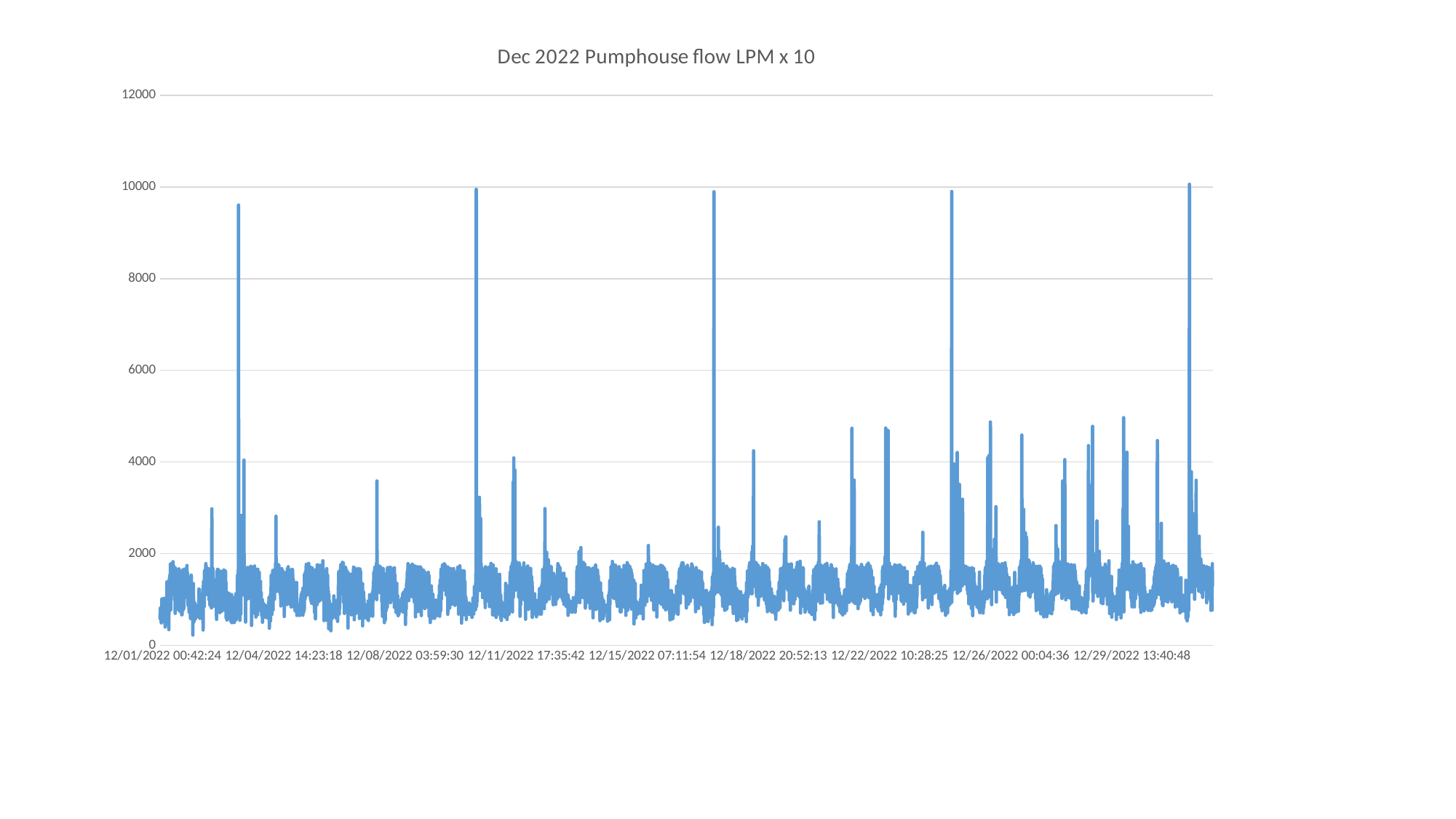
What is the highest value shown on the vertical axis? 12000 What is the first date label on the horizontal axis? 12/01/2022 00:42:24 Is the highest peak in the chart greater or less than 8000? greater How many date labels are shown along the horizontal axis? 9 What kind of chart is shown on the slide? line chart How many spikes in the chart rise above 8000? 5 Is the typical baseline flow level in the chart greater or less than 2000? less What is the title of the chart? Dec 2022 Pumphouse flow LPM x 10 Is the peak near 12/04/2022 greater or less than 8000? greater What is the last date label on the horizontal axis? 12/29/2022 13:40:48